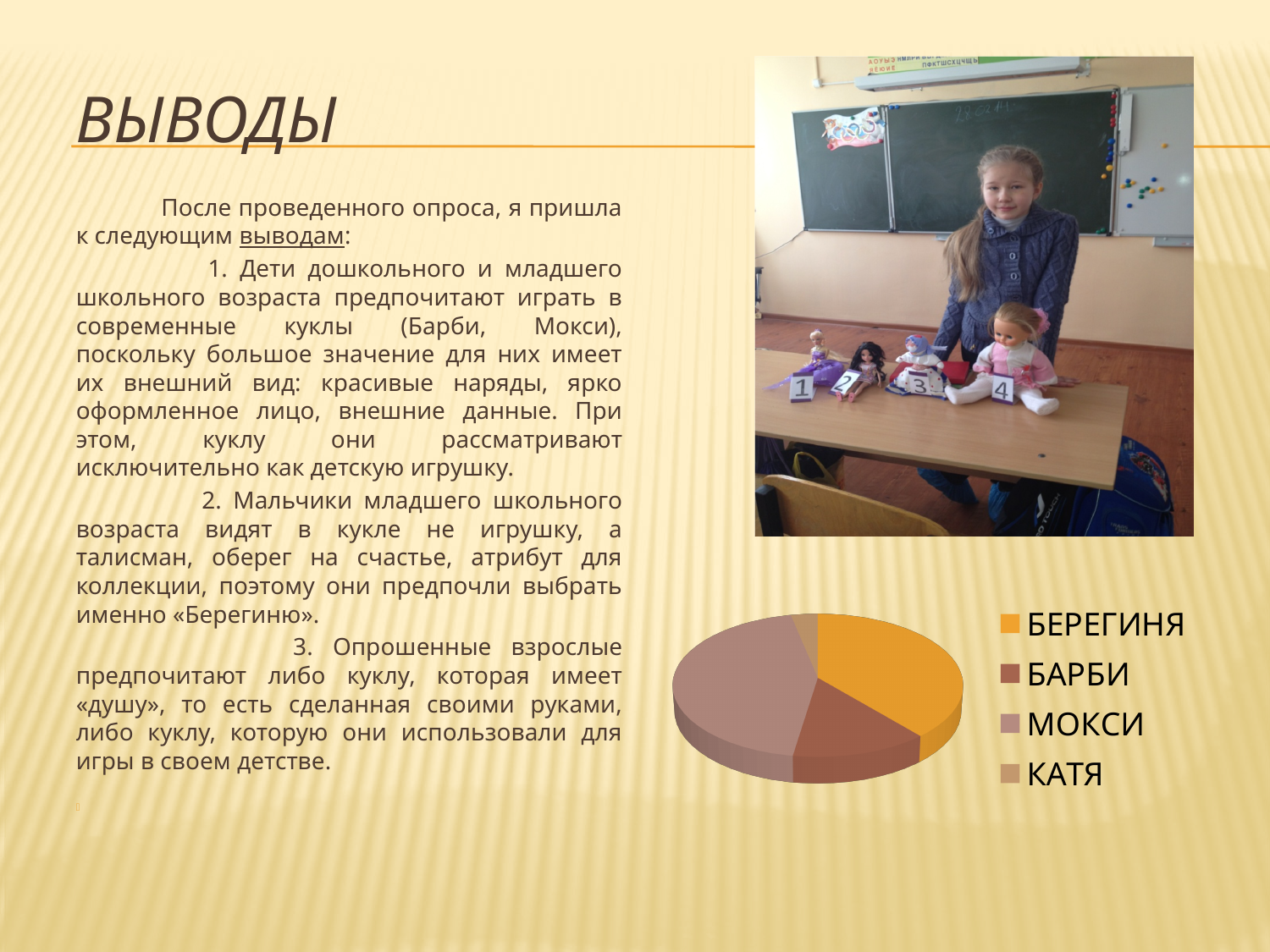
Which category is listed first in the pie chart's legend? БЕРЕГИНЯ Which slice is larger in the pie chart, БЕРЕГИНЯ or КАТЯ? БЕРЕГИНЯ Which category has the smallest slice in the pie chart? КАТЯ What kind of chart is shown on the slide? pie chart Which slice is larger in the pie chart, БАРБИ or КАТЯ? БАРБИ Which category is shown in orange in the pie chart? БЕРЕГИНЯ How many categories does the pie chart's legend list? 4 Which slice is larger in the pie chart, МОКСИ or КАТЯ? МОКСИ